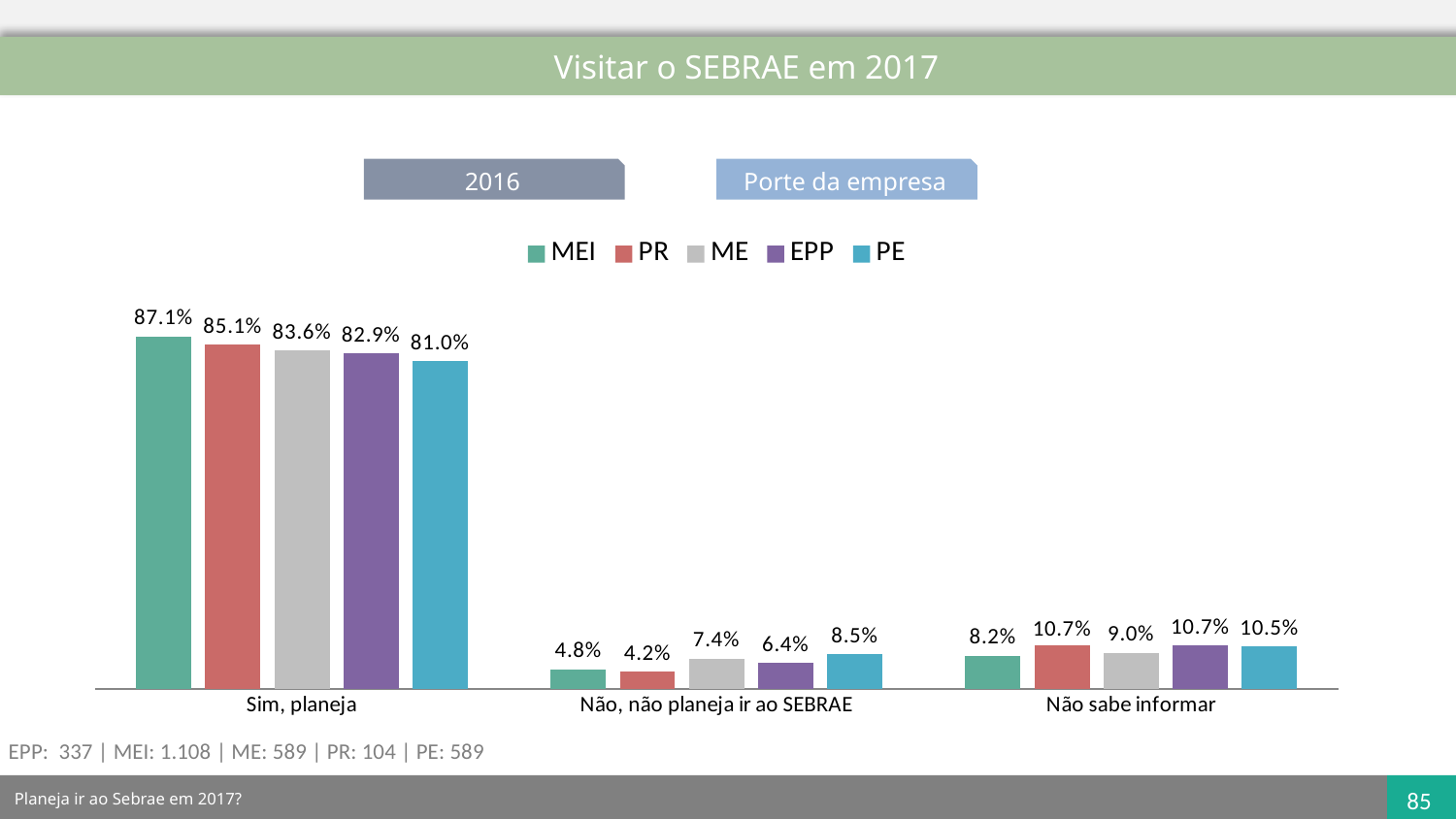
How many series does the legend list? 5 What is the value for PE in the 'Não, não planeja ir ao SEBRAE' category? 8.5% Which is larger in the 'Não sabe informar' category: the value for MEI or the value for PE? PE Which series has the highest value in the 'Sim, planeja' category? MEI What is the difference between the MEI and PE values in the 'Sim, planeja' category? 6.1% What kind of chart is shown on the slide? Bar chart What is the value for ME in the 'Não sabe informar' category? 9.0% Which series has the lowest value in the 'Não, não planeja ir ao SEBRAE' category? PR What is the title of the slide? Visitar o SEBRAE em 2017 Which series is shown in purple in the legend? EPP How many categories are shown on the x axis? 3 What is the value for MEI in the 'Sim, planeja' category? 87.1%